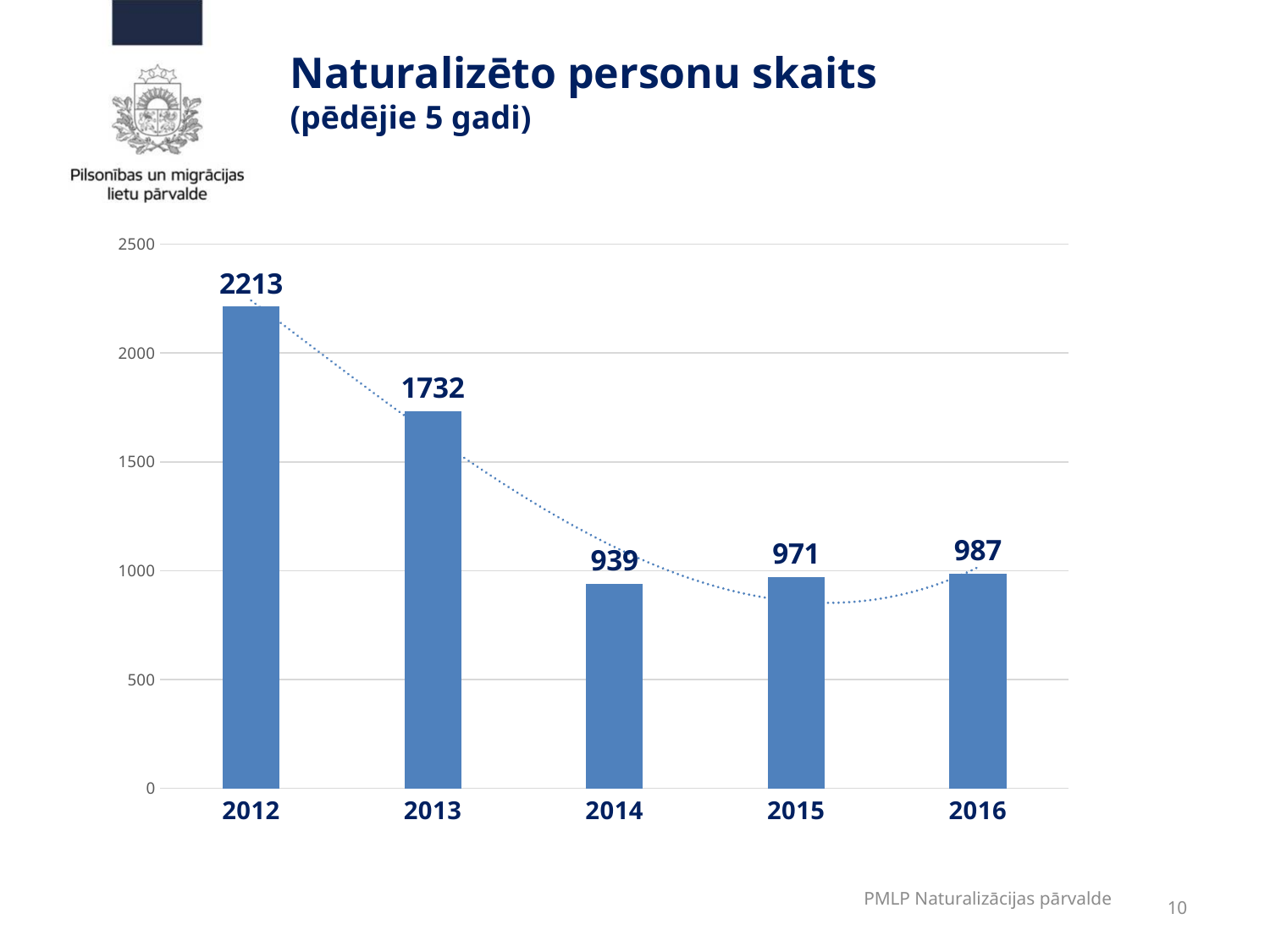
What value is shown for 2016? 987 What is the difference between the values for 2016 and 2015? 16 Which year has the highest value? 2012 How many years are shown on the x axis? 5 Which year has the lowest value? 2014 What is the difference between the values for 2012 and 2013? 481 What value is shown for 2014? 939 Do the values generally rise or fall from 2012 to 2014? fall What kind of chart is shown on the slide? bar chart What was the number of naturalized persons in 2012? 2213 Which year has a larger value, 2013 or 2015? 2013 Is the value for 2015 greater or less than 1000? less